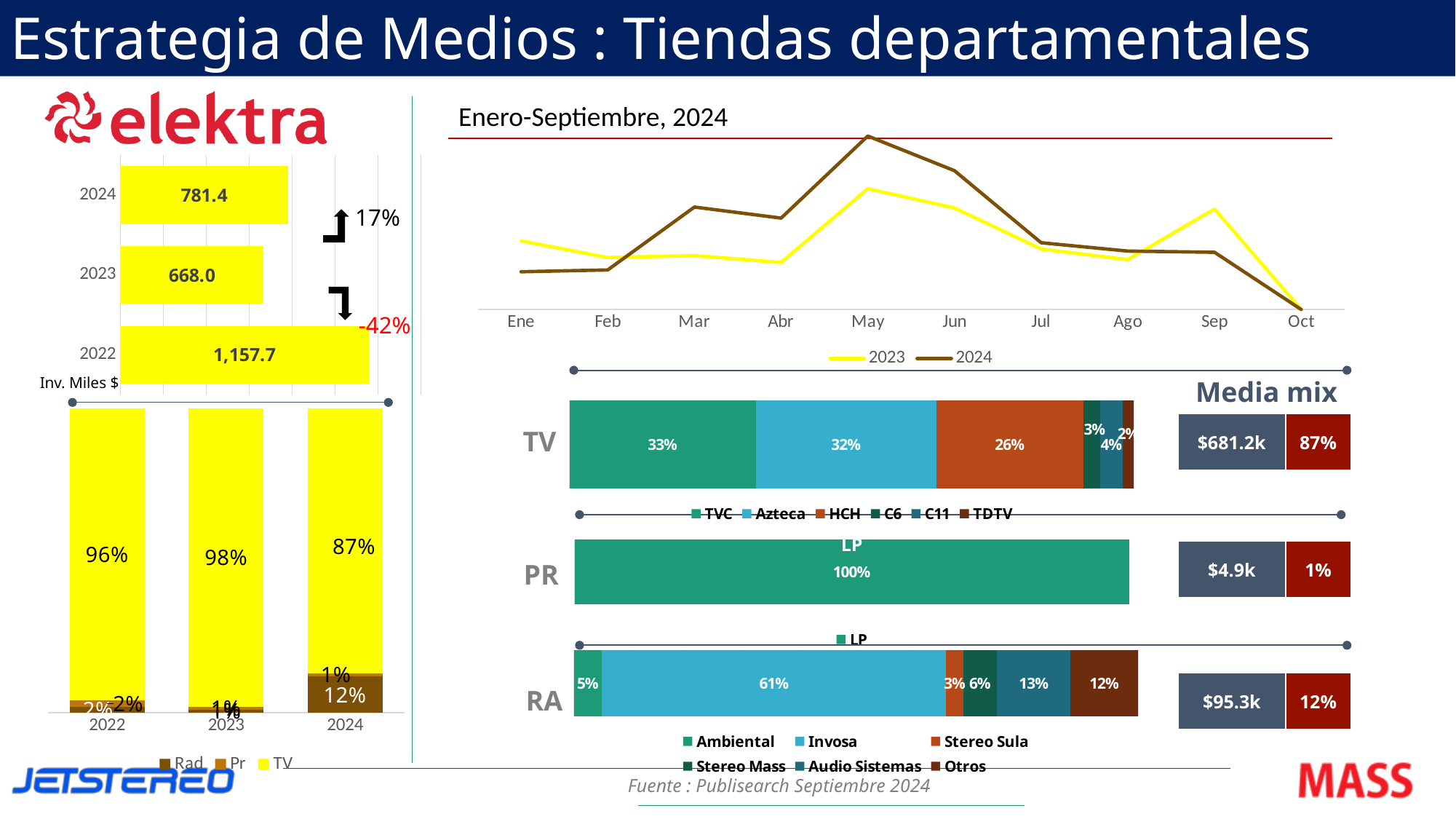
In the TV stacked bar on the right, which is larger, Azteca or HCH? Azteca How many months are shown on the x axis of the 'Enero-Septiembre, 2024' line chart? 10 In the horizontal bar chart on the left (Inv. Miles $), what is the difference between the 2024 value and the 2023 value? 113.4 In the horizontal bar chart on the left (Inv. Miles $), which year has the highest value? 2022 What kind of chart is the 'Enero-Septiembre, 2024' chart at the top right? line chart How many series does the legend of the 'Enero-Septiembre, 2024' line chart list? 2 In the horizontal bar chart on the left (Inv. Miles $), what is the value for 2024? 781.4 In the stacked bar chart at the bottom left, which year has the highest TV share? 2023 In the TV stacked bar on the right, what is the share for TVC? 33% In the Media mix boxes on the right, what is the amount shown for TV? $681.2k In the stacked bar chart at the bottom left, what is the TV share for 2024? 87% In the RA stacked bar on the right, which station has the largest share? Invosa